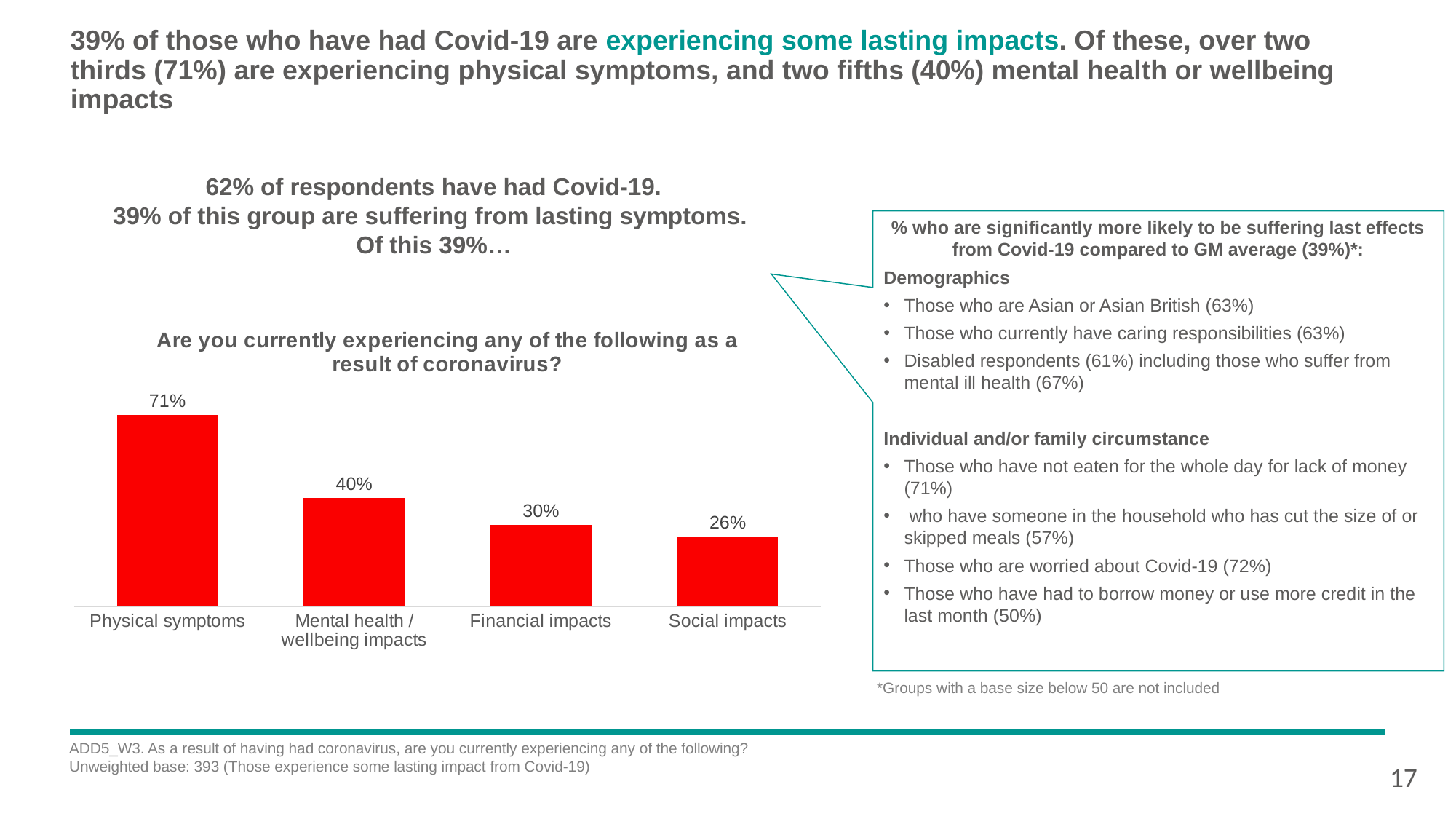
What type of chart is shown on the slide? Bar chart Which is larger, the value for Mental health / wellbeing impacts or the value for Financial impacts? Mental health / wellbeing impacts What is the difference between the values for Physical symptoms and Mental health / wellbeing impacts? 31 percentage points How many categories are shown in the chart? 4 What is the title of the chart? Are you currently experiencing any of the following as a result of coronavirus? Which category has the lowest value in the chart? Social impacts What percentage of respondents are experiencing physical symptoms as a result of coronavirus? 71% What is the difference between the values for Financial impacts and Social impacts? 4 percentage points What is the value shown for Mental health / wellbeing impacts? 40% Which category has the highest value in the chart? Physical symptoms What is the value shown for Social impacts? 26% What is the value shown for Financial impacts? 30%